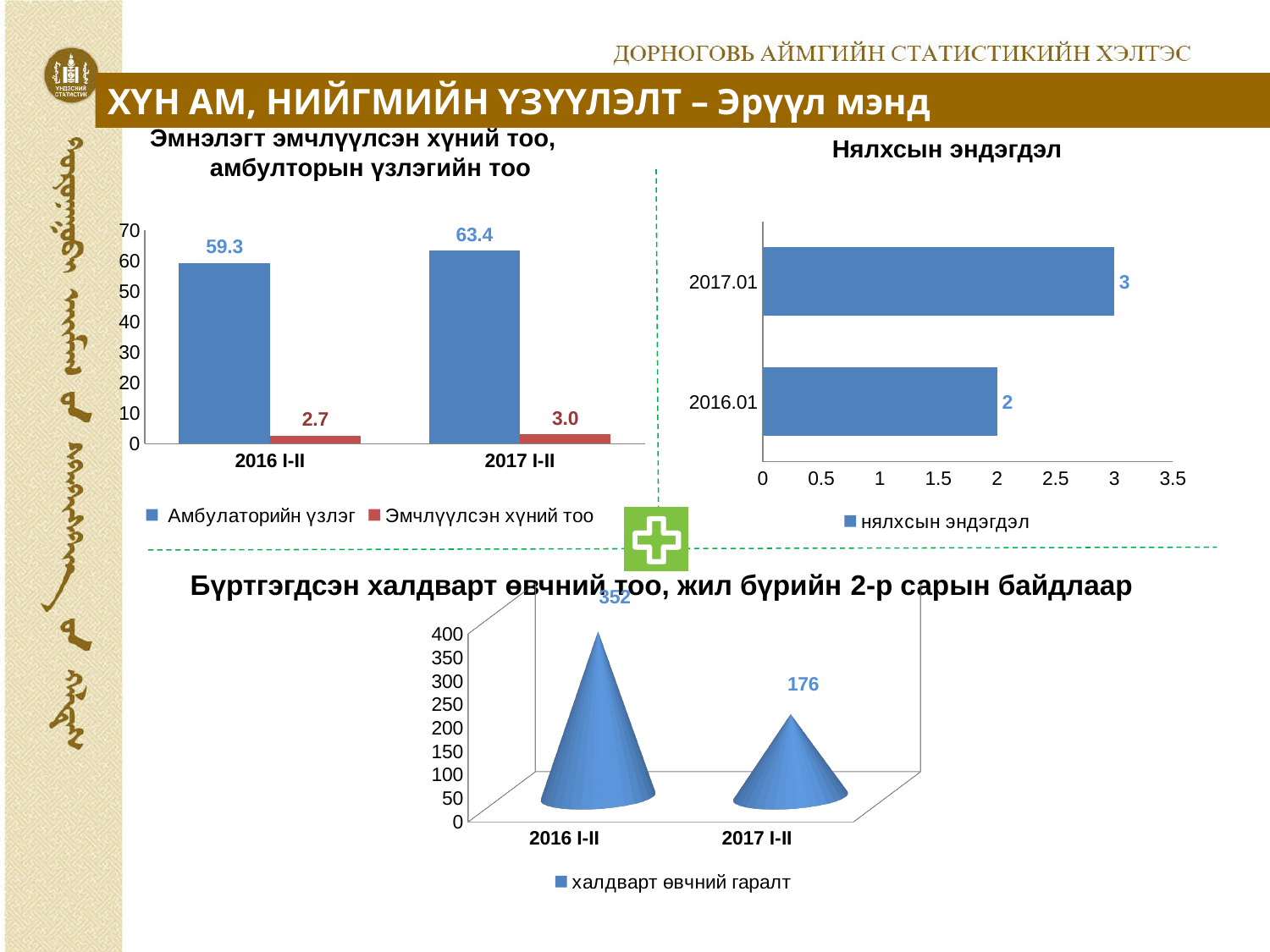
In the bottom chart 'Бүртгэгдсэн халдварт өвчний тоо', what is the value for 2016 I-II? 352 In the bottom chart 'Бүртгэгдсэн халдварт өвчний тоо', what is the difference between the 2016 I-II and 2017 I-II values? 176 In the top-left chart, how many series does the legend list? 2 In the top-left chart, what is the value of Эмчлүүлсэн хүний тоо for 2016 I-II? 2.7 In the top-left chart, what is the difference between the Амбулаторийн үзлэг values for 2017 I-II and 2016 I-II? 4.1 In the bottom chart, what is the legend entry? халдварт өвчний гаралт In the top-left chart 'Эмнэлэгт эмчлүүлсэн хүний тоо, амбулторын үзлэгийн тоо', what is the value of Амбулаторийн үзлэг for 2017 I-II? 63.4 In the top-left chart, does the Амбулаторийн үзлэг value rise or fall from 2016 I-II to 2017 I-II? rise In the top-right chart 'Нялхсын эндэгдэл', what is the value for 2017.01? 3 In the top-right chart 'Нялхсын эндэгдэл', which category has the lowest value? 2016.01 In the bottom chart 'Бүртгэгдсэн халдварт өвчний тоо', which category has the highest value? 2016 I-II What kind of chart is the top-right chart 'Нялхсын эндэгдэл'? bar chart